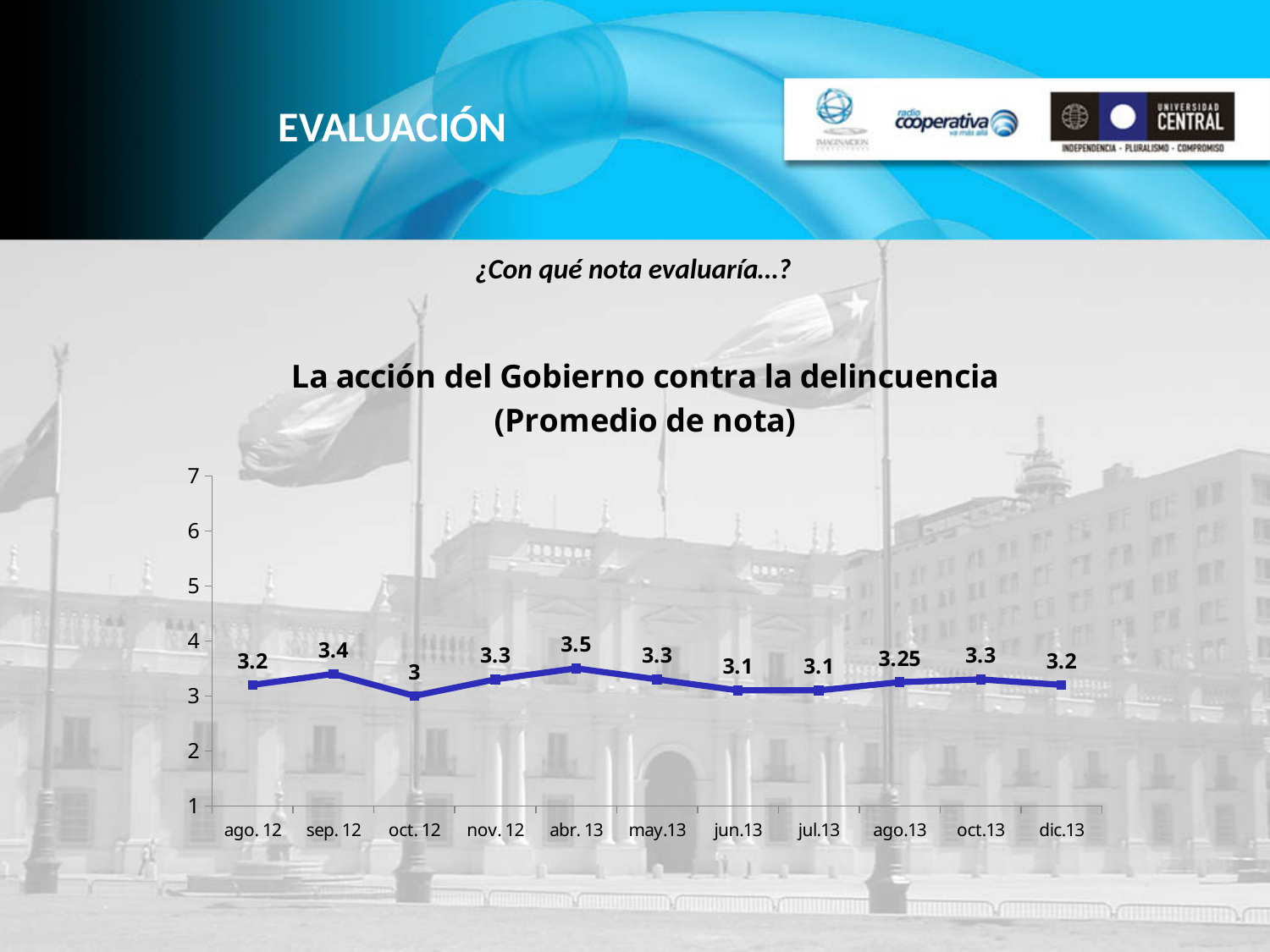
Which month has the lowest value? oct. 12 Is the value for dic.13 greater or less than 4? less What is the title of the chart? La acción del Gobierno contra la delincuencia (Promedio de nota) Which is larger, the value for sep. 12 or the value for jun.13? sep. 12 What is the difference between the values for abr. 13 and oct. 12? 0.5 What is the value for oct. 12? 3 What is the value for ago.13? 3.25 What kind of chart is shown? line chart How many months are plotted on the x axis? 11 What is the value for abr. 13? 3.5 Do the values rise or fall from jul.13 to oct.13? rise Which month has the highest value? abr. 13